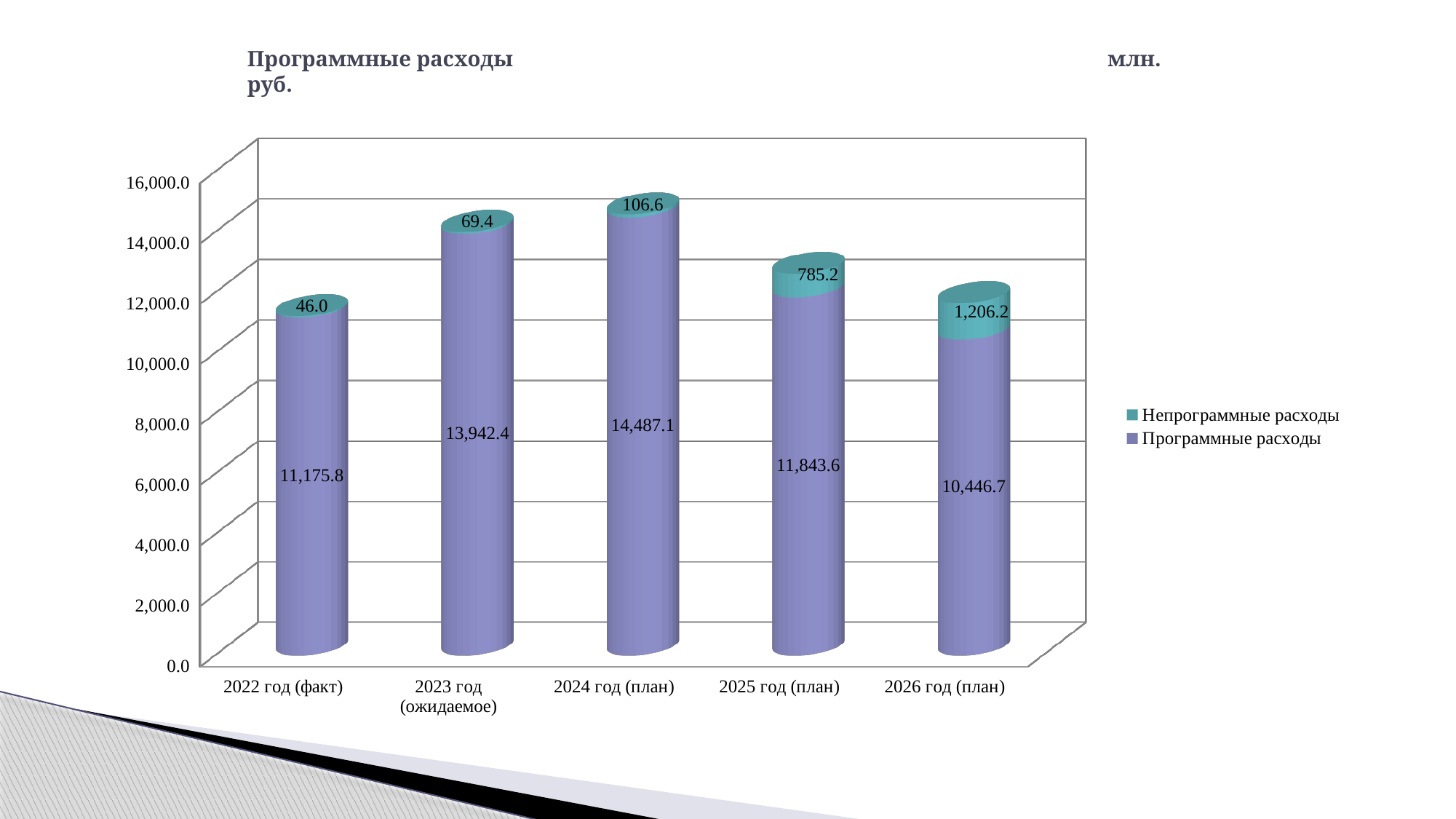
Which is larger: Непрограммные расходы for 2025 год (план) or for 2026 год (план)? 2026 год (план) Which category has the highest value of Программные расходы? 2024 год (план) What is the value of Непрограммные расходы for 2026 год (план)? 1,206.2 What is the value of Программные расходы for 2024 год (план)? 14,487.1 What is the difference between Программные расходы for 2023 год (ожидаемое) and 2022 год (факт)? 2,766.6 How many categories are shown on the x axis? 5 How many series does the legend list? 2 What is the total of the stacked bar for 2025 год (план)? 12,628.8 What is the value of Программные расходы for 2022 год (факт)? 11,175.8 Which category has the lowest value of Непрограммные расходы? 2022 год (факт) What kind of chart is shown on the slide? Stacked bar chart Which colour represents Непрограммные расходы in the legend? Teal